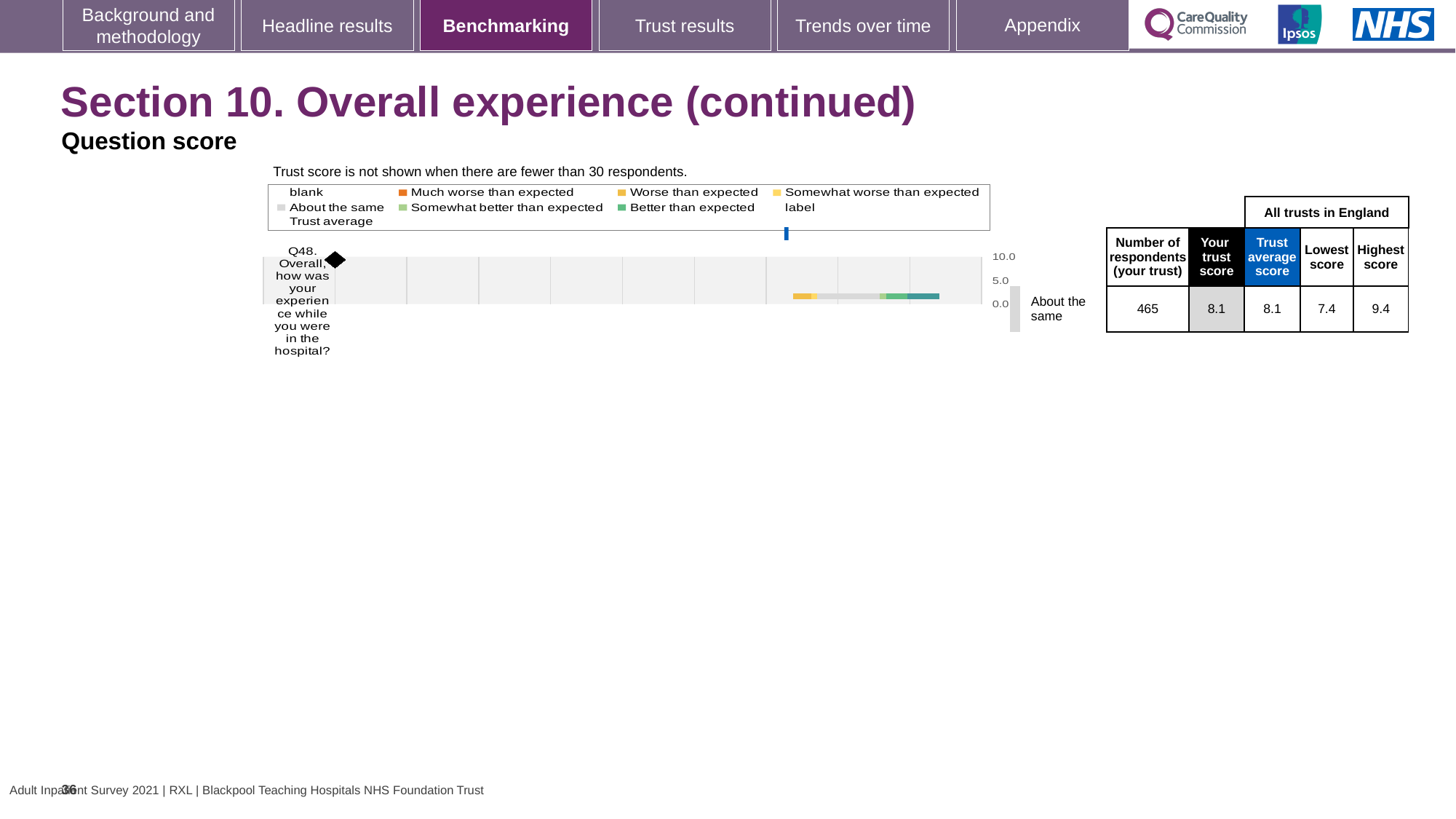
In the table, what is the trust average score for Q48? 8.1 Which is larger for Q48: your trust score or the lowest score? Your trust score In the table, what is the highest score among all trusts in England for Q48? 9.4 What benchmark category is shown next to the bar for Q48? About the same In the table, what is your trust score for Q48? 8.1 What kind of chart is shown on the slide? bar chart How many survey questions are plotted in the chart? 1 What is the difference between the highest score and the lowest score for Q48? 2.0 In the table, what is the lowest score among all trusts in England for Q48? 7.4 What is the maximum value shown on the chart's score axis? 10.0 Which question is plotted in the chart? Q48. Overall, how was your experience while you were in the hospital? In the table, what is the number of respondents for your trust for Q48? 465